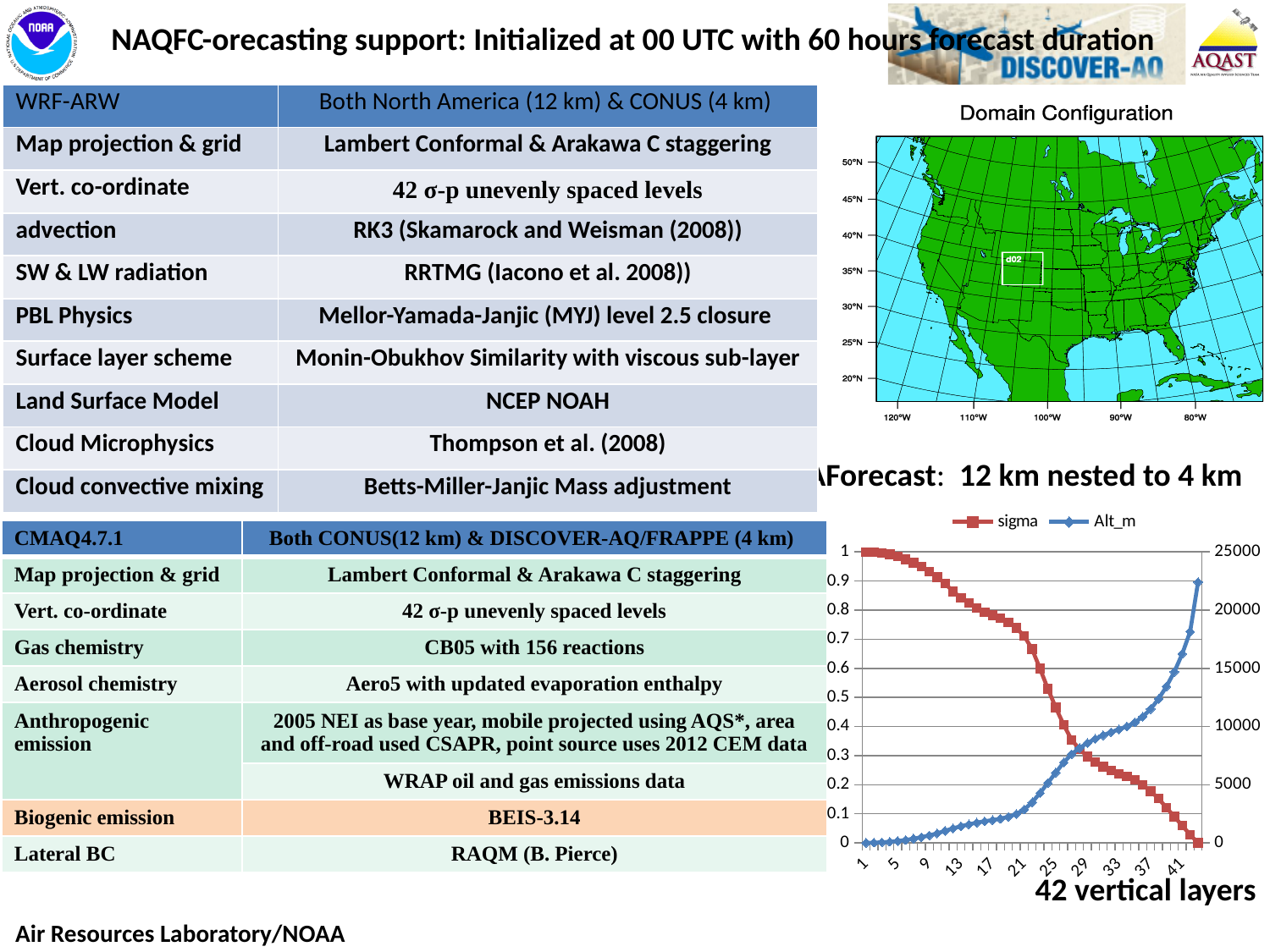
In the bottom-right chart, is the Alt_m value at layer 21 greater or less than 5000? less What are the two series named in the legend of the bottom-right chart? sigma and Alt_m In the bottom-right chart, is the sigma value at layer 21 greater or less than 0.5? greater In the bottom-right chart, is the Alt_m value at the last layer greater or less than 20000? greater What kind of chart is shown at the bottom right of the slide? line chart How many series does the legend of the bottom-right chart list? 2 In the bottom-right chart, what is the sigma value at layer 1? 1 In the bottom-right chart, does the sigma series rise or fall as the layer number increases along the x axis? fall In the bottom-right chart, does the Alt_m series rise or fall as the layer number increases along the x axis? rise How many vertical layers does the bottom-right chart represent, according to its caption? 42 In the bottom-right chart, which series is drawn in red with square markers? sigma